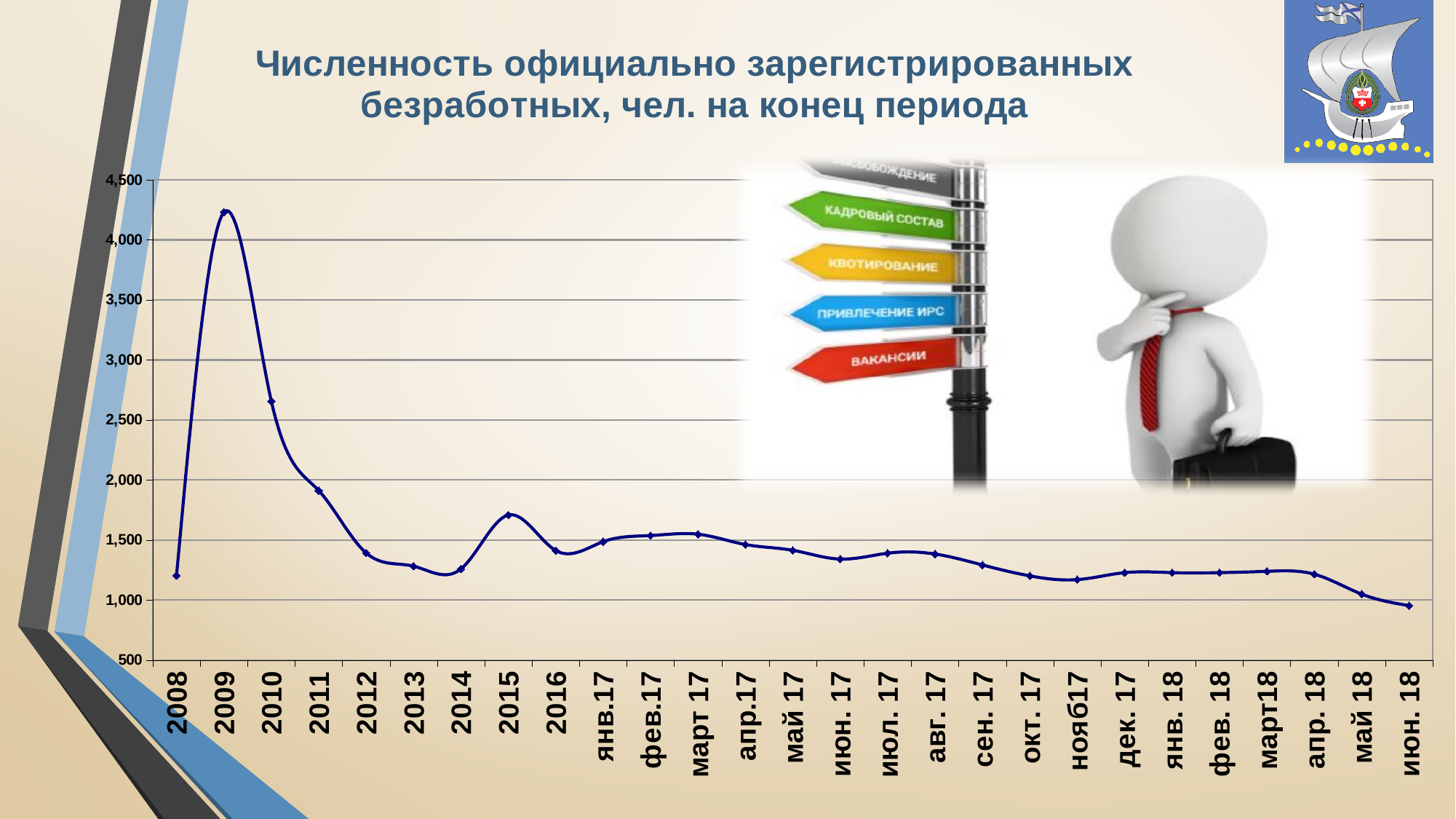
Do the values rise or fall from 2009 to 2012? fall Is the value for 2011 greater or less than 2,000? less Which is larger, the value for 2010 or the value for 2011? 2010 Is the value for июн. 18 greater or less than 1,000? less Is the value for 2009 greater or less than 4,000? greater Which period has the lowest number of registered unemployed? июн. 18 What kind of chart is shown on the slide? line chart Which is larger, the value for 2015 or the value for 2016? 2015 How many periods are plotted on the x axis? 27 Which period has the highest number of registered unemployed? 2009